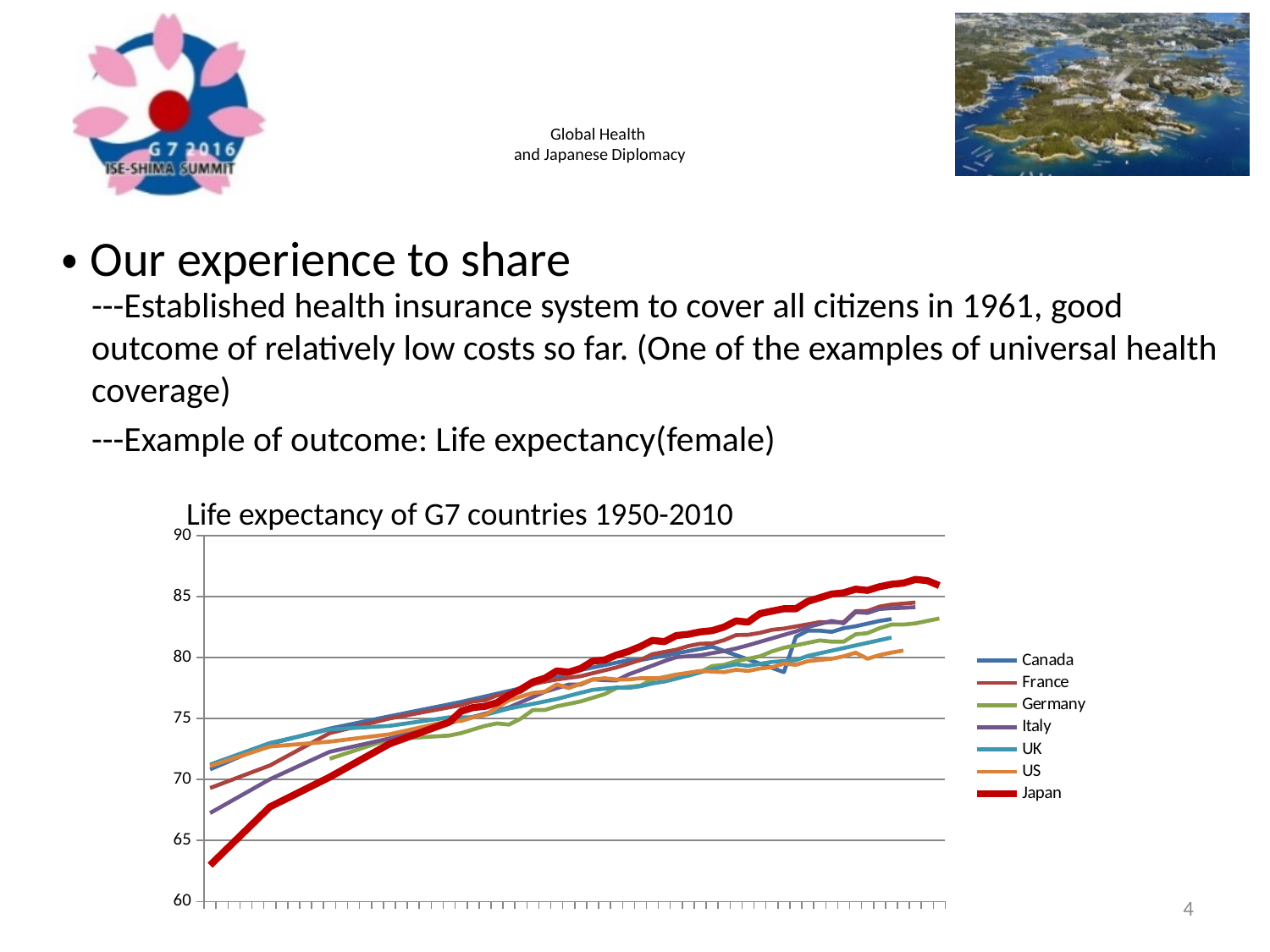
How many series does the legend of the chart list? 7 Is the value for Japan at the right end of the chart greater or less than 85? greater Is the value for Japan at the left end of the chart greater or less than 65? less What kind of chart is shown on the slide? line chart Is the value for the US at the right end of the chart greater or less than 85? less Does the line for Japan rise or fall from left to right across the chart? rise Which country has the lowest life expectancy at the left end of the chart? Japan Which country has the highest life expectancy at the right end of the chart? Japan Which country's line is drawn in thick red in the chart? Japan Which country has the lowest life expectancy at the right end of the chart? US At the right end of the chart, which is larger, the value for Japan or the value for the US? Japan What is the title of the chart? Life expectancy of G7 countries 1950-2010